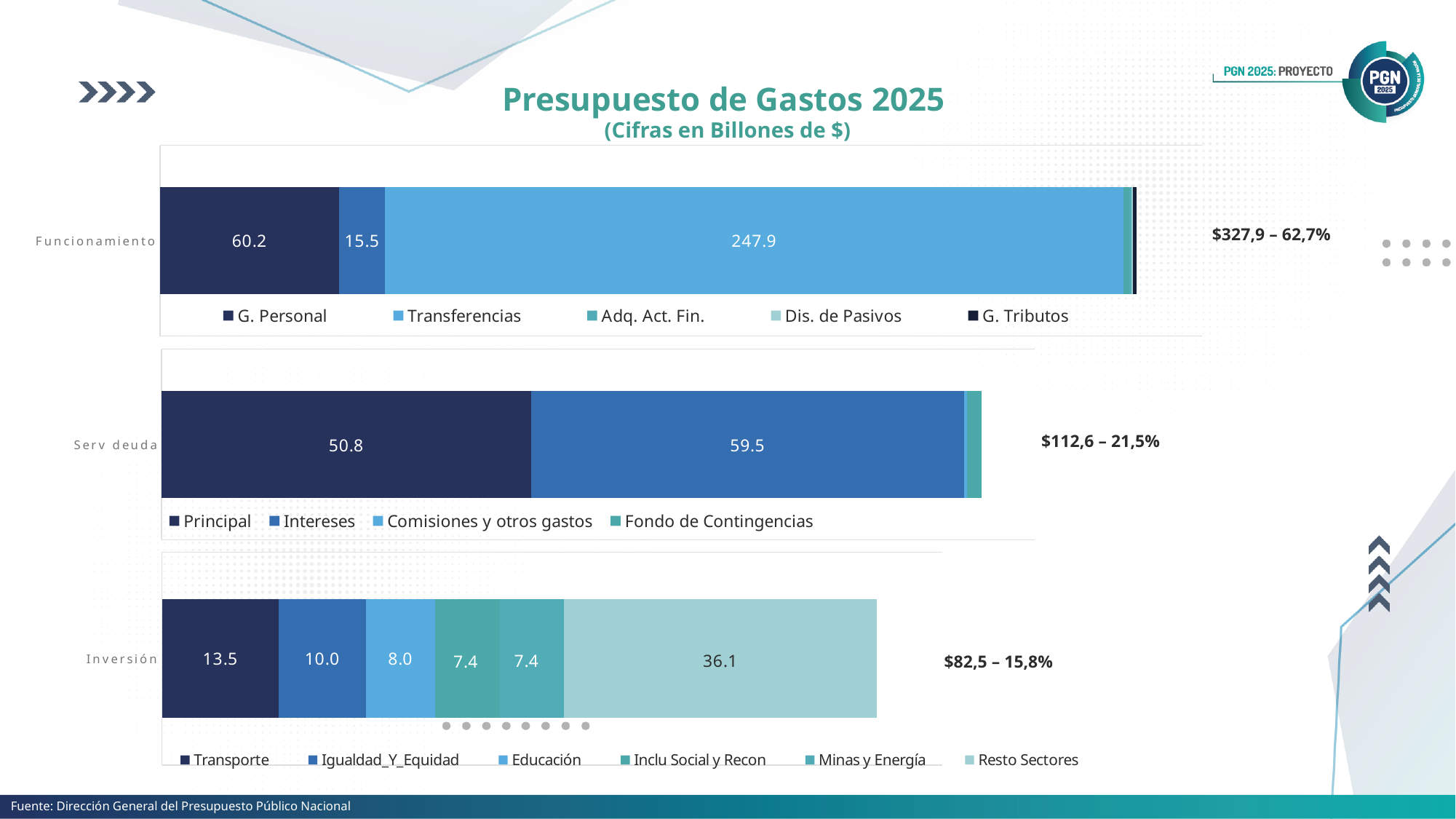
In the Funcionamiento chart, what is the value for Transferencias? 247.9 What kind of chart is used for the Serv deuda data? Stacked bar chart In the Inversión chart, which segment has the highest value? Resto Sectores In the Funcionamiento chart, which segment has the highest value? Transferencias In the Funcionamiento chart, what is the value for G. Personal? 60.2 In the Inversión chart, what is the value for Resto Sectores? 36.1 In the Serv deuda chart, what is the difference between Intereses and Principal? 8.7 In the Serv deuda chart, which is larger, Principal or Intereses? Intereses In the Serv deuda chart, what is the value for Principal? 50.8 How many series does the legend of the Inversión chart list? 6 In the Serv deuda chart, what is the value for Intereses? 59.5 In the Inversión chart, what is the value for Transporte? 13.5